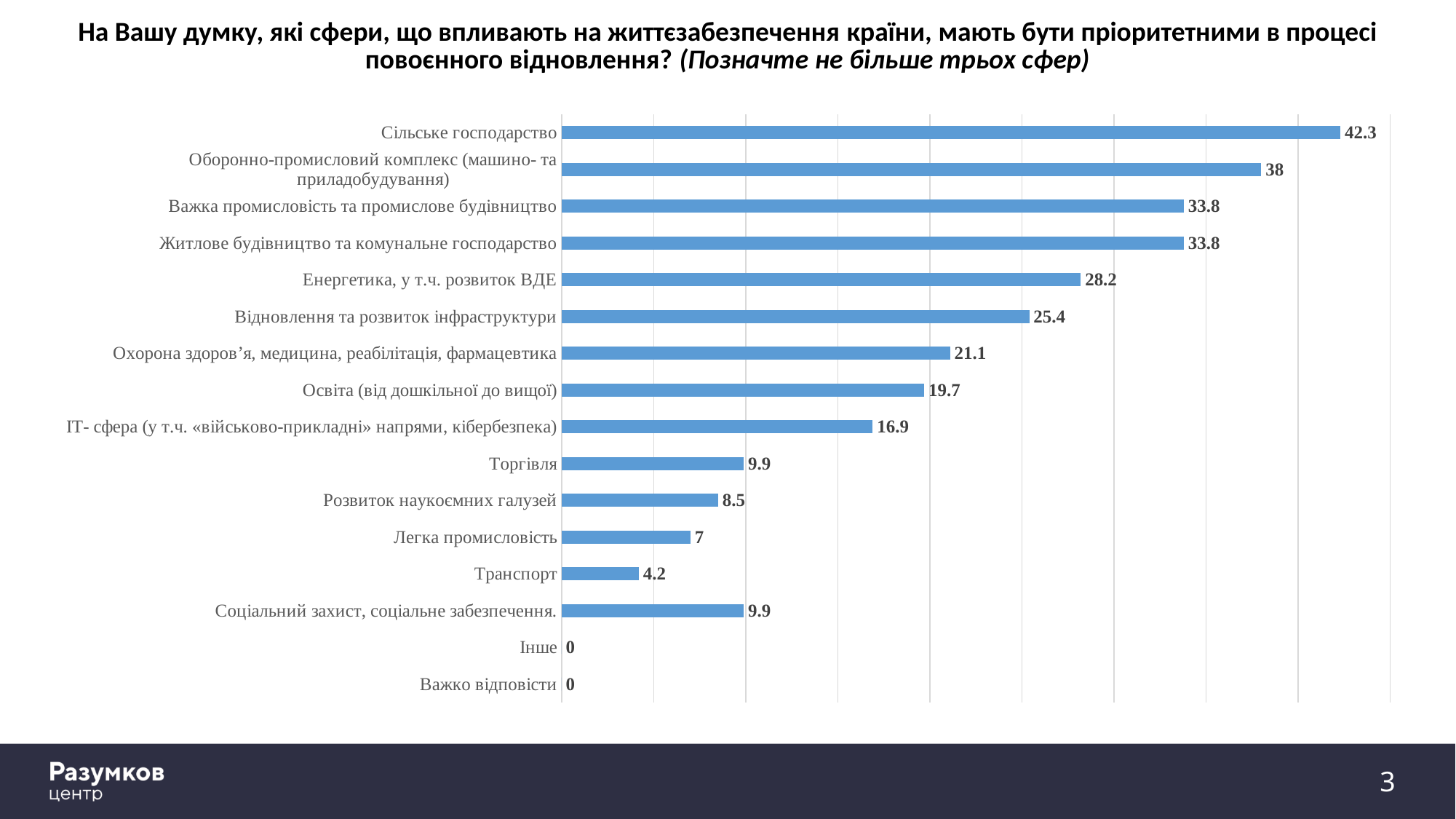
What is the value for Транспорт? 4.2 Which is larger, the value for Охорона здоров’я, медицина, реабілітація, фармацевтика or the value for Відновлення та розвиток інфраструктури? Відновлення та розвиток інфраструктури What is the difference between the values for Сільське господарство and Оборонно-промисловий комплекс (машино- та приладобудування)? 4.3 What is the value for Сільське господарство? 42.3 How many categories have a value of 0? 2 Which category has the highest value? Сільське господарство What is the value for Енергетика, у т.ч. розвиток ВДЕ? 28.2 What kind of chart is shown on the slide? Bar chart What is the value for ІТ- сфера (у т.ч. «військово-прикладні» напрями, кібербезпека)? 16.9 Which is larger, the value for Торгівля or the value for Транспорт? Торгівля How many categories are shown in the chart? 16 What is the difference between the values for Освіта (від дошкільної до вищої) and Торгівля? 9.8